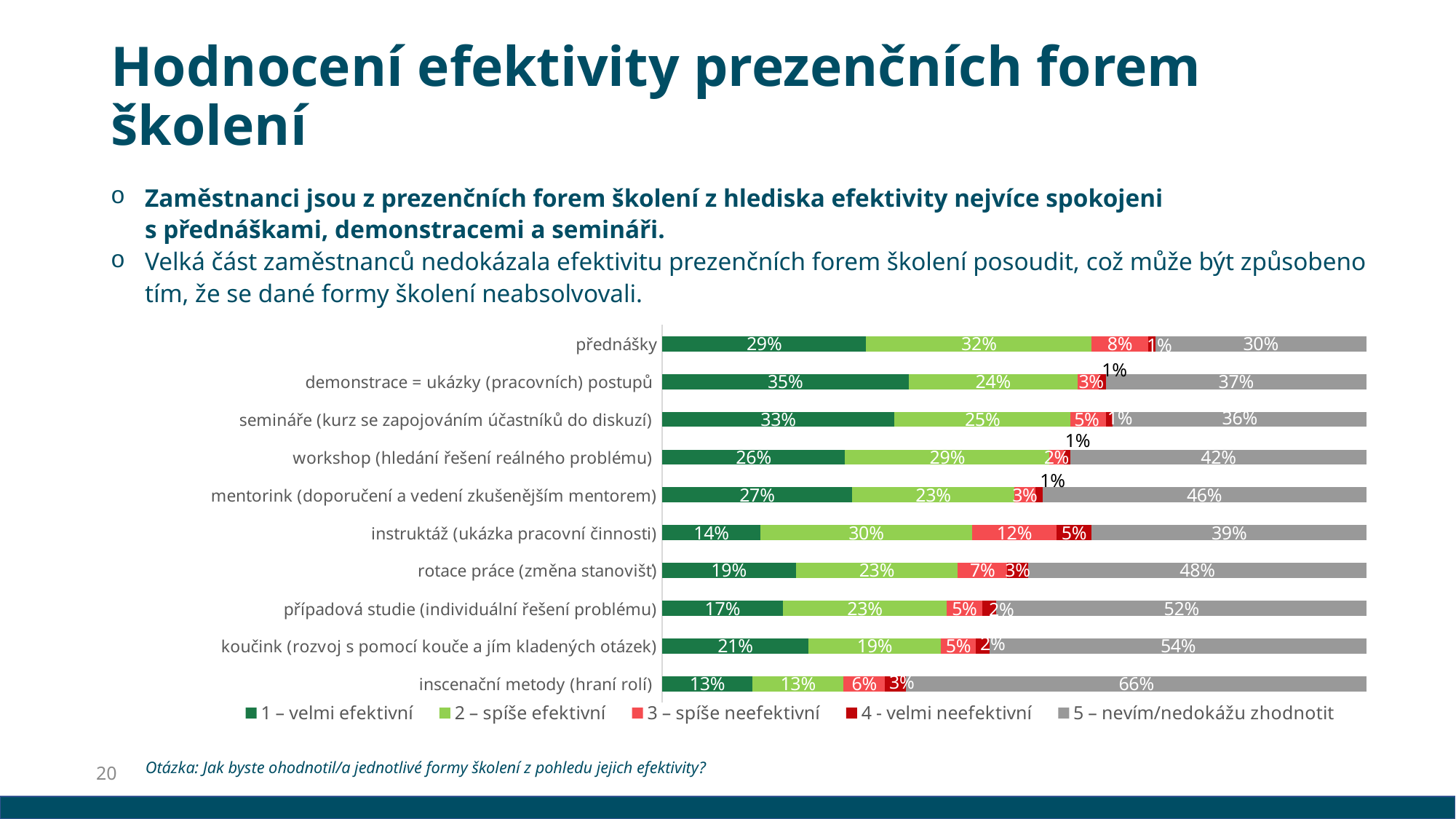
What percentage of respondents rated 'přednášky' as '1 – velmi efektivní'? 29% What is the difference between the '5 – nevím/nedokážu zhodnotit' values for 'koučink' and 'přednášky'? 24% Which training form has the highest share of '1 – velmi efektivní' ratings? demonstrace = ukázky (pracovních) postupů What is the combined share of '1 – velmi efektivní' and '2 – spíše efektivní' for 'semináře (kurz se zapojováním účastníků do diskuzí)'? 58% Which colour represents the series '4 - velmi neefektivní' in the legend? dark red How many training forms (categories) are shown in the chart? 10 Which training form has the lowest share of '5 – nevím/nedokážu zhodnotit' ratings? přednášky What percentage of respondents rated 'instruktáž (ukázka pracovní činnosti)' as '3 – spíše neefektivní'? 12% What type of chart is shown on the slide? stacked bar chart How many series does the legend list? 5 Which has a larger '2 – spíše efektivní' value: 'přednášky' or 'workshop (hledání řešení reálného problému)'? přednášky What is the value of '5 – nevím/nedokážu zhodnotit' for 'inscenační metody (hraní rolí)'? 66%